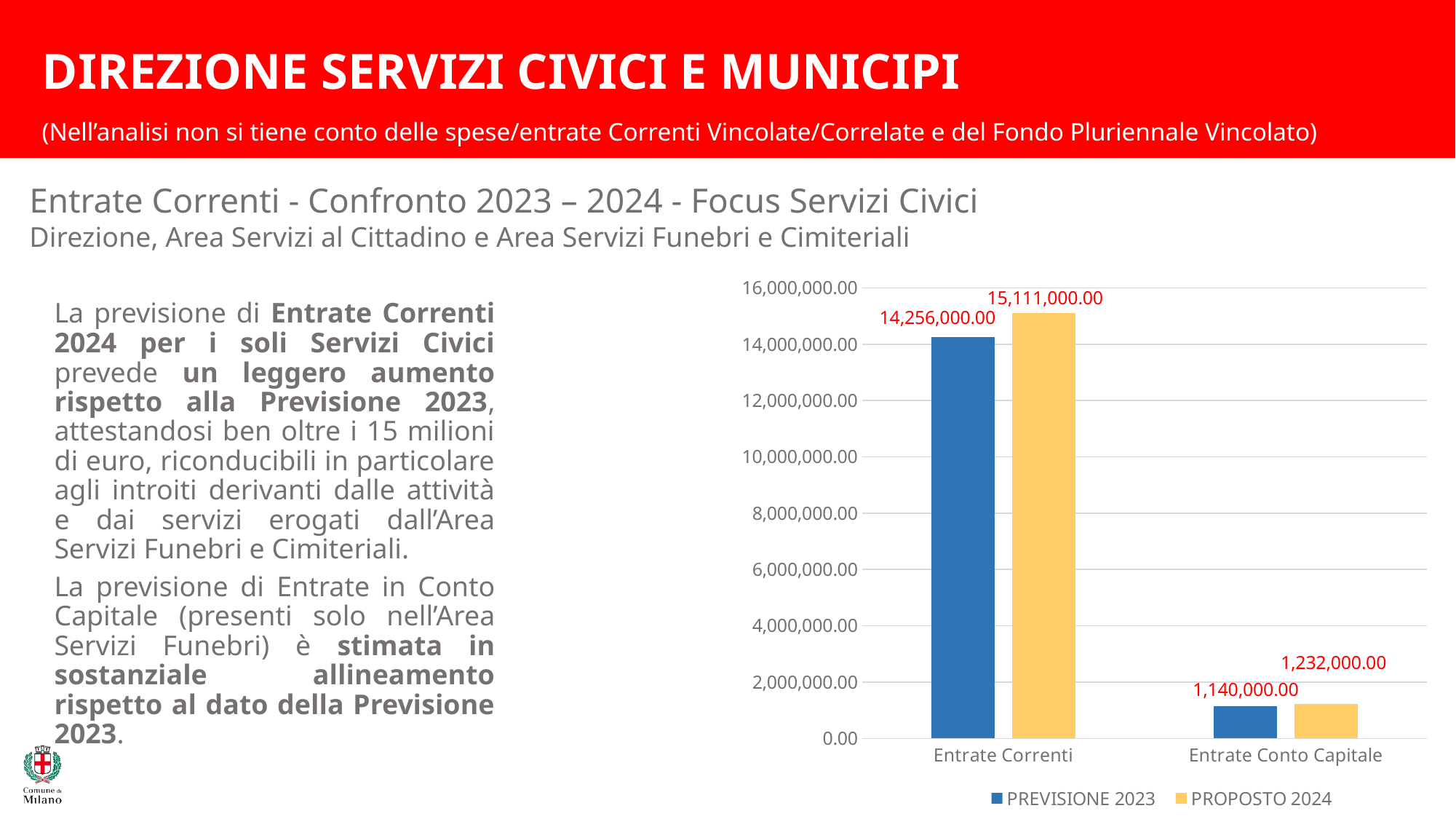
What is the difference between the PROPOSTO 2024 and PREVISIONE 2023 values for Entrate Conto Capitale? 92,000.00 What is the PREVISIONE 2023 value for Entrate Conto Capitale? 1,140,000.00 How many categories are shown on the x axis of the chart? 2 How many series does the chart legend list? 2 For Entrate Correnti, which is larger: PREVISIONE 2023 or PROPOSTO 2024? PROPOSTO 2024 What is the PROPOSTO 2024 value for Entrate Conto Capitale? 1,232,000.00 What is the PROPOSTO 2024 value for Entrate Correnti? 15,111,000.00 What kind of chart is shown on the slide? Bar chart Which category has the lowest PREVISIONE 2023 value? Entrate Conto Capitale What is the PREVISIONE 2023 value for Entrate Correnti? 14,256,000.00 Which category has the highest PROPOSTO 2024 value? Entrate Correnti What is the difference between the PROPOSTO 2024 and PREVISIONE 2023 values for Entrate Correnti? 855,000.00